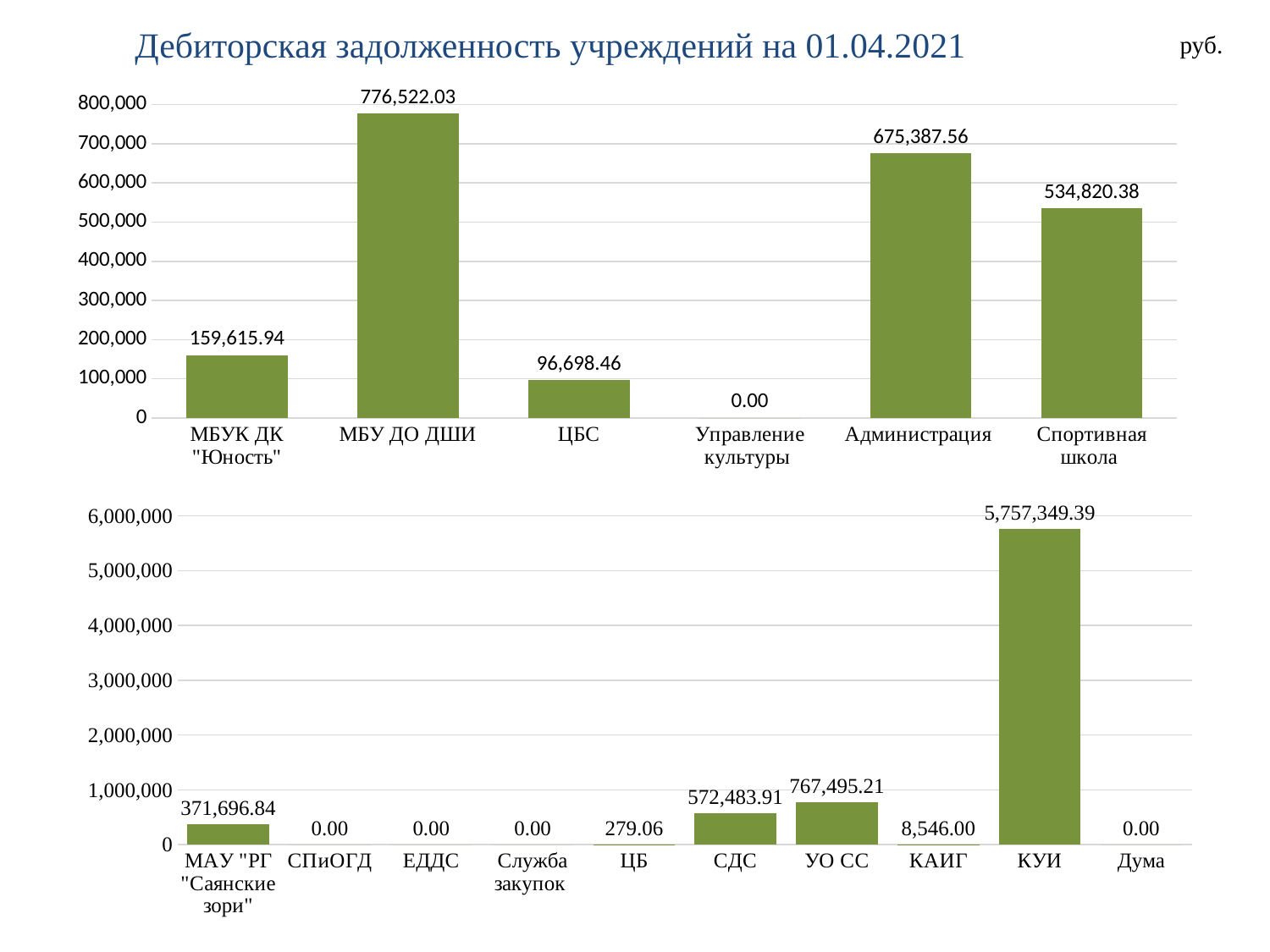
In the bottom chart, how many categories are shown on the x axis? 10 In the top chart, what is the difference between the values for МБУ ДО ДШИ and Администрация? 101,134.47 In the bottom chart, what is the value for КАИГ? 8,546.00 In the top chart, which category has the lowest value? Управление культуры In the bottom chart, which category has the highest value? КУИ In the top chart, what is the value for Спортивная школа? 534,820.38 In the top chart, how many categories are shown on the x axis? 6 In the top chart, what is the value for МБУ ДО ДШИ? 776,522.03 In the bottom chart, what is the difference between the values for УО СС and СДС? 195,011.30 In the bottom chart, what is the value for КУИ? 5,757,349.39 What kind of chart is the top chart? Bar chart In the bottom chart, which is larger, the value for СДС or the value for УО СС? УО СС